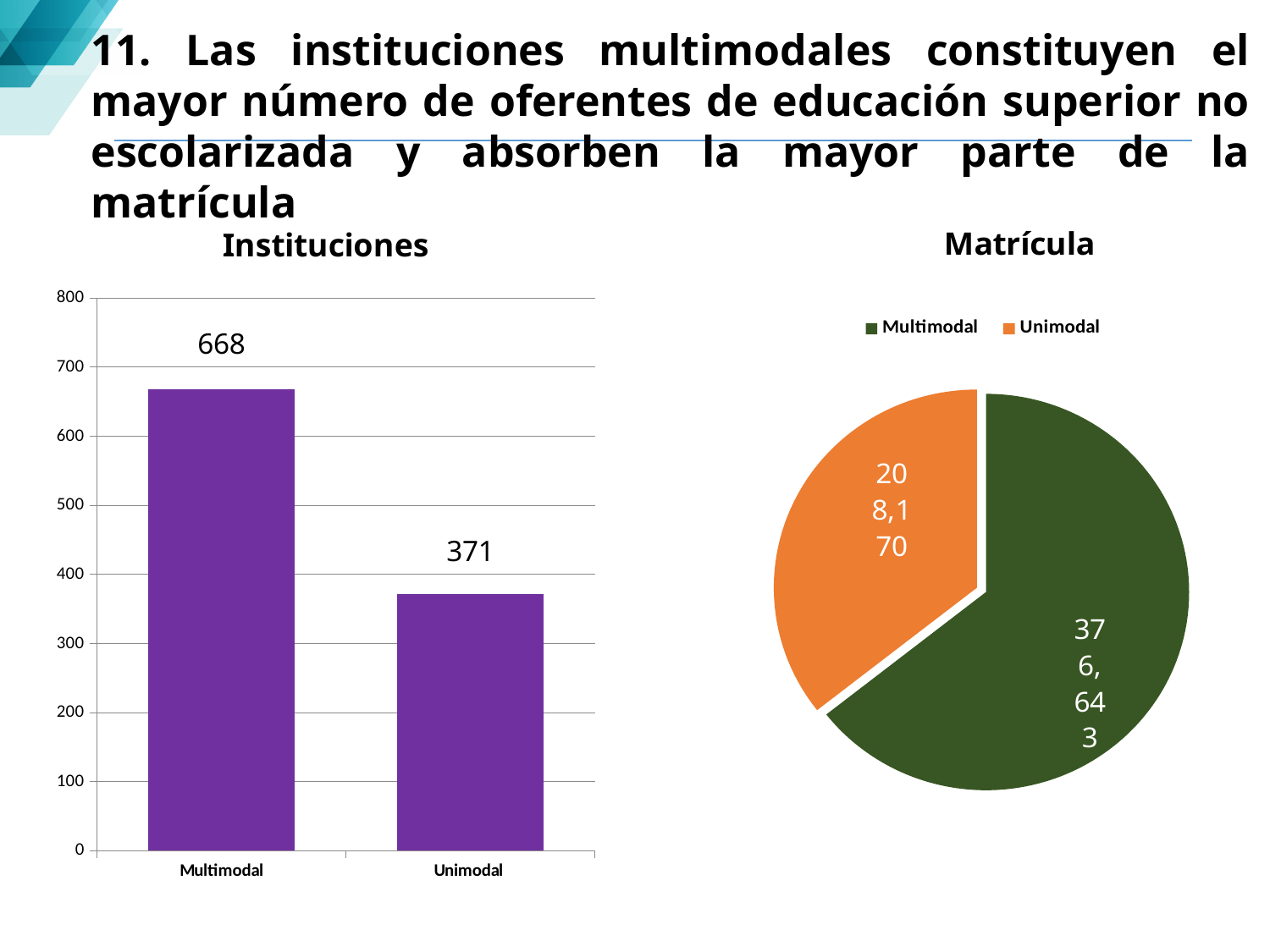
In the Instituciones chart, how many categories are shown on the x axis? 2 In the Instituciones chart, which category has the highest value? Multimodal In the Matrícula chart, which category has the larger slice? Multimodal In the Matrícula chart, what colour is the Unimodal slice? orange In the Instituciones chart, what is the difference between the Multimodal and Unimodal values? 297 In the Instituciones chart, what is the value for Unimodal? 371 In the Instituciones chart, what is the value for Multimodal? 668 In the Matrícula chart, how many entries does the legend list? 2 In the Instituciones chart, which category has the lowest value? Unimodal What kind of chart is the Instituciones chart? bar chart In the Instituciones chart, is the value for Unimodal greater or less than 400? less What kind of chart is the Matrícula chart? pie chart